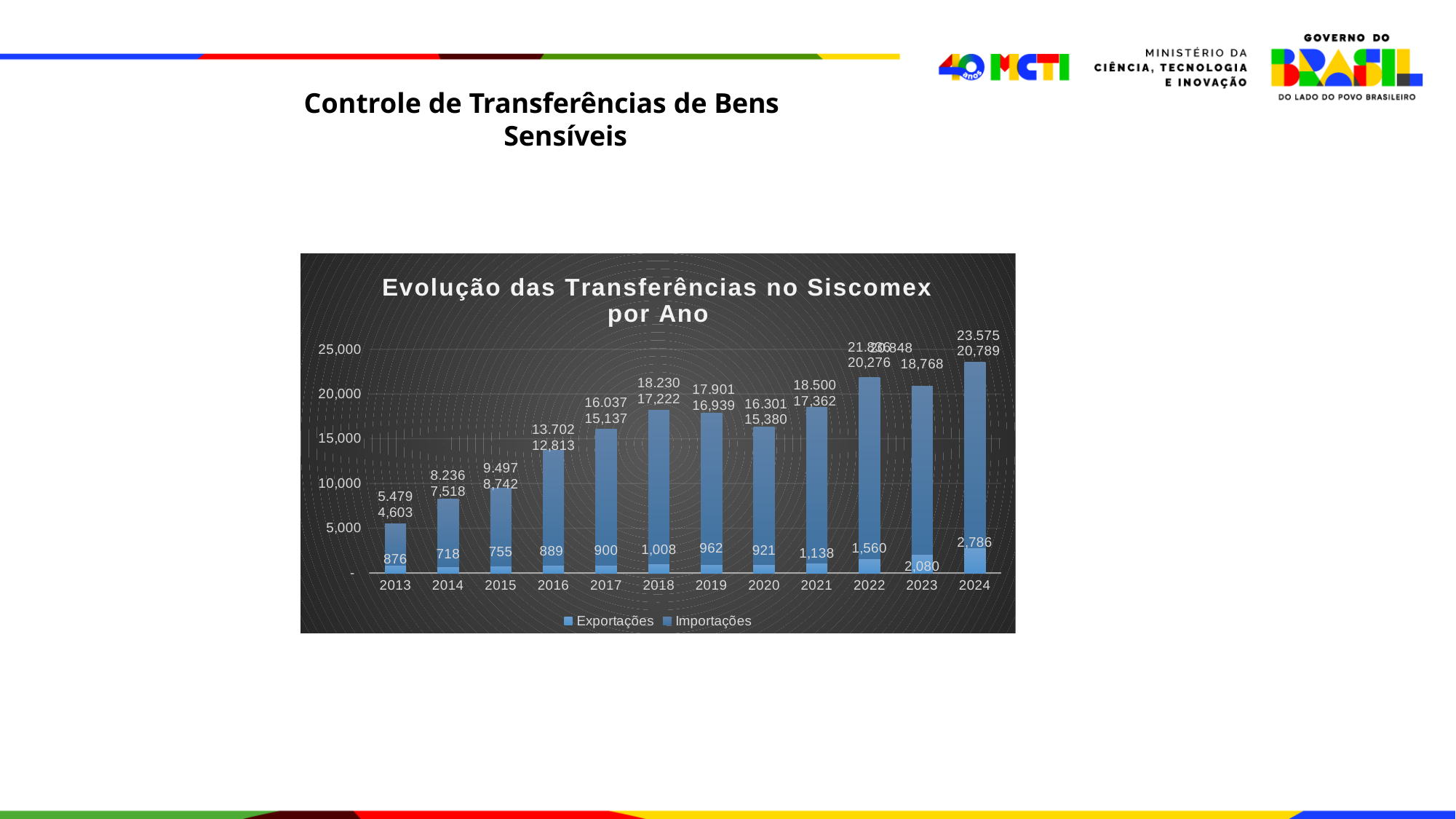
What is the value for Exportações in 2021? 1,138 What is the title of the chart? Evolução das Transferências no Siscomex por Ano What is the difference between the Importações values for 2014 and 2013? 2,915 What is the value for Importações in 2013? 4,603 How many years are shown on the x axis? 12 In which year is the Exportações value lowest? 2014 What is the value for Importações in 2019? 16,939 How many series does the legend list? 2 What kind of chart is shown on the slide? Stacked bar chart Which year has the larger Importações value, 2017 or 2020? 2020 What is the value for Exportações in 2024? 2,786 In which year is the Importações value highest? 2024